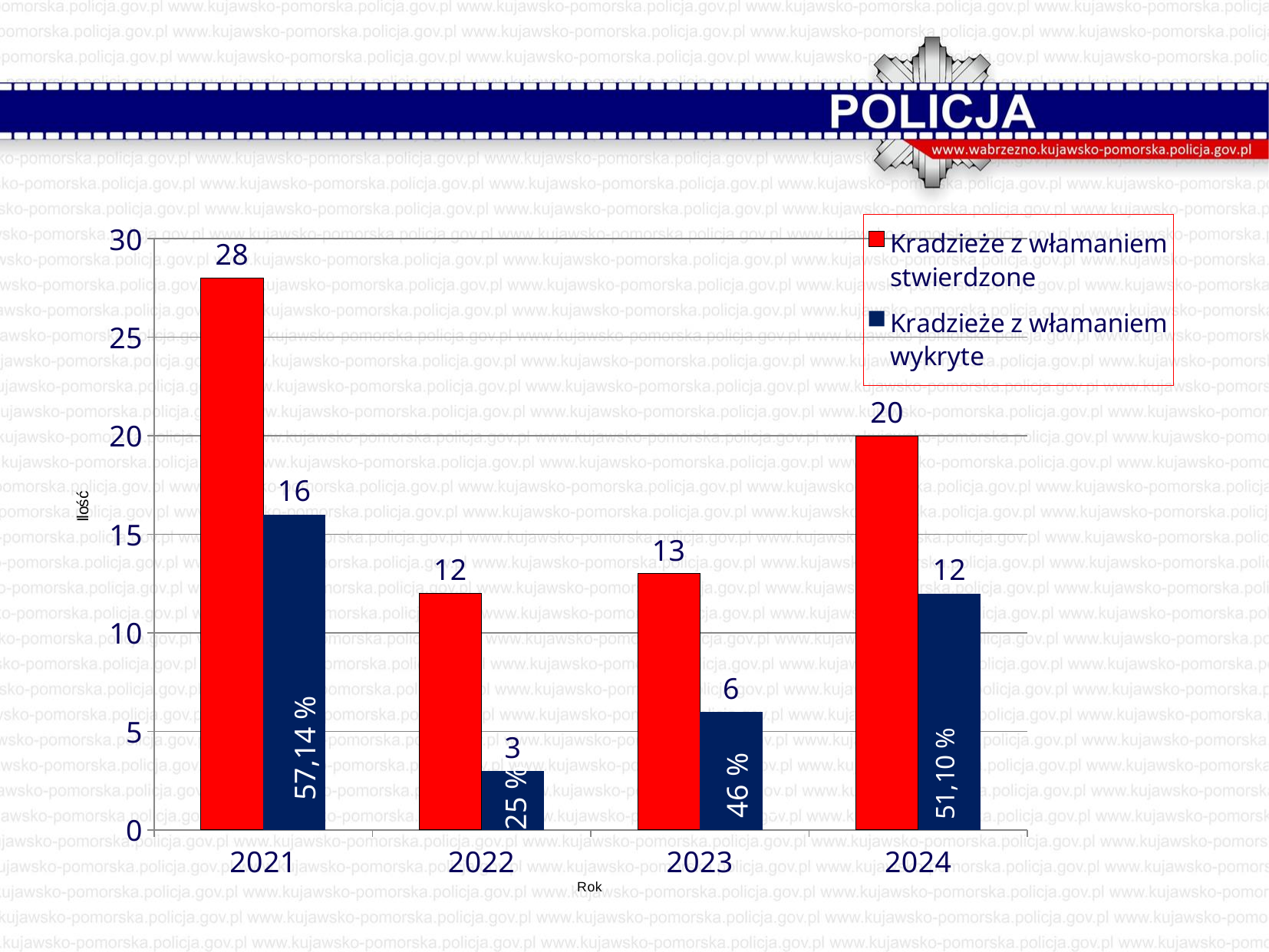
Which is larger: 'Kradzieże z włamaniem stwierdzone' in 2022 or in 2024? 2024 What is the value of 'Kradzieże z włamaniem wykryte' for 2022? 3 What is the difference between 'Kradzieże z włamaniem stwierdzone' and 'Kradzieże z włamaniem wykryte' in 2023? 7 Is the value for 'Kradzieże z włamaniem stwierdzone' in 2021 greater or less than 25? greater Which year has the lowest value for 'Kradzieże z włamaniem wykryte'? 2022 What is the value of 'Kradzieże z włamaniem wykryte' for 2024? 12 What kind of chart is shown on the slide? bar chart What is the value of 'Kradzieże z włamaniem stwierdzone' for 2021? 28 How many years are shown on the x axis? 4 What percentage label is printed on the 'Kradzieże z włamaniem wykryte' bar for 2021? 57,14 % Which year has the highest value for 'Kradzieże z włamaniem stwierdzone'? 2021 How many series does the legend list? 2